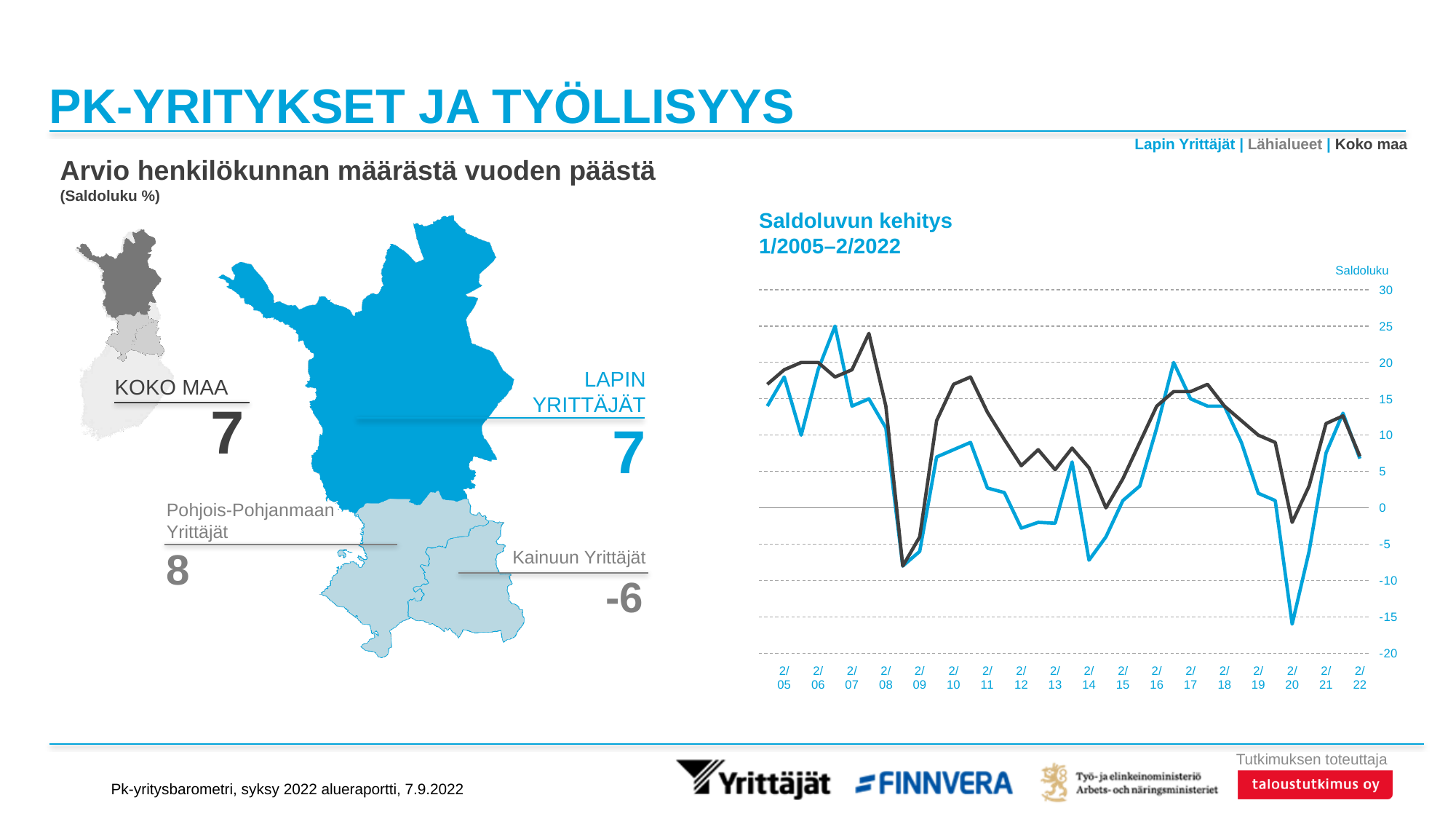
On the map chart, what is the saldoluku value shown for Lapin Yrittäjät? 7 On the map chart, what is the difference between the values for Pohjois-Pohjanmaan Yrittäjät and Kainuun Yrittäjät? 14 In the 'Saldoluvun kehitys' chart, is the value of the blue line at 2/20 greater or less than -10? less In the 'Saldoluvun kehitys' chart, how many time points are labelled on the x axis? 18 In the 'Saldoluvun kehitys' chart, does the blue line rise or fall from 2/20 to 2/21? rise On the map chart, what is the value shown for Kainuun Yrittäjät? -6 On the map chart, which region has the highest value? Pohjois-Pohjanmaan Yrittäjät What kind of chart is 'Saldoluvun kehitys 1/2005–2/2022'? line chart On the map chart, what is the value shown for Pohjois-Pohjanmaan Yrittäjät? 8 In the 'Saldoluvun kehitys' chart, at 2/20, which line is lower, the blue line or the black line? the blue line On the map chart, which region has the lowest value? Kainuun Yrittäjät